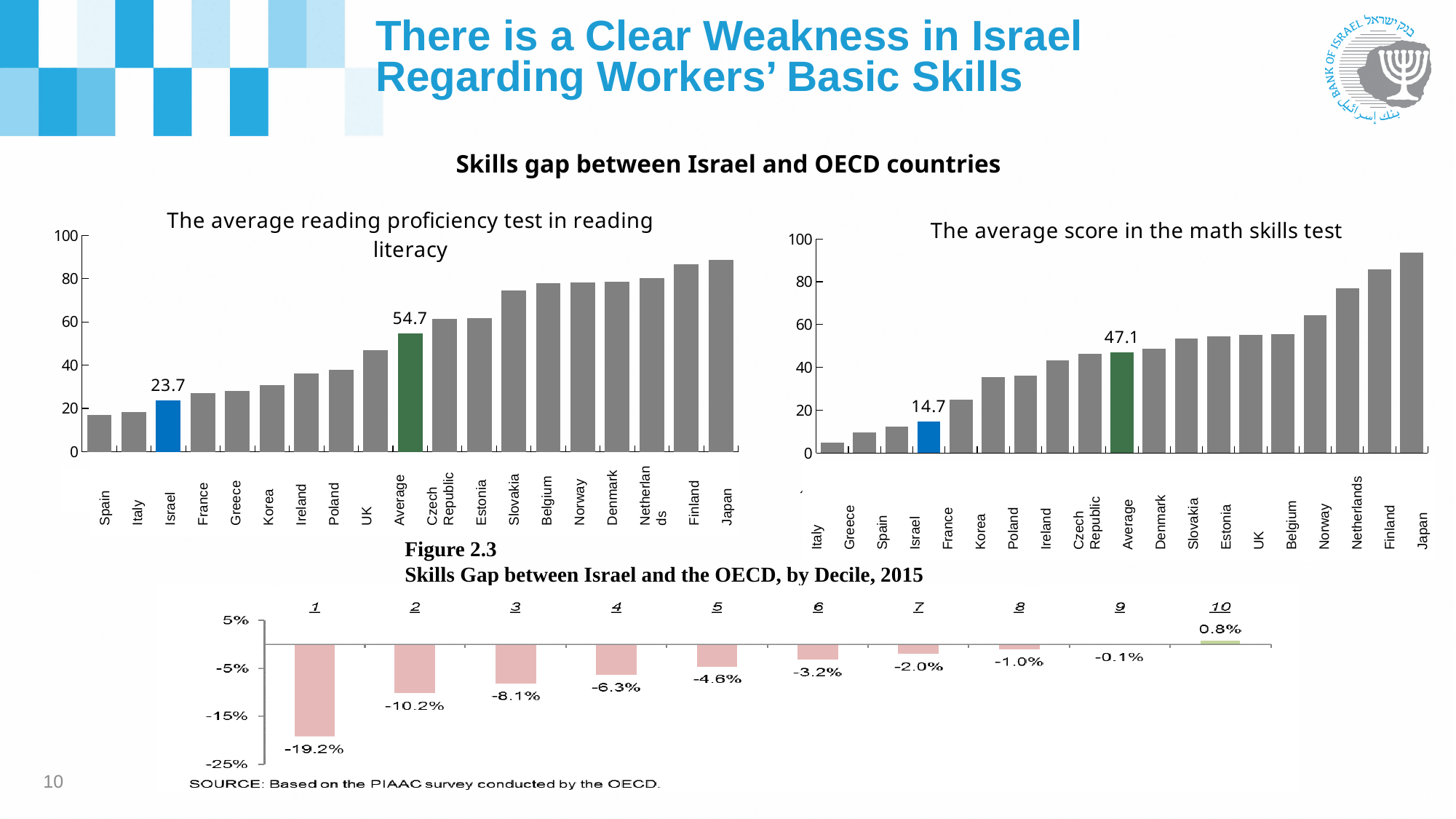
In the reading literacy chart, what is the value for Average? 54.7 In the math skills test chart, what is the difference between the Average value and Israel's value? 32.4 In the math skills test chart, which country has the lowest value? Italy In the reading literacy chart, what is the difference between the Average value and Israel's value? 31.0 In the reading literacy chart, which country has the highest value? Japan In the Skills Gap by Decile chart, how many deciles are plotted? 10 In the reading literacy chart, what is the value for Israel? 23.7 In the math skills test chart, what is the value for Israel? 14.7 In the Skills Gap by Decile chart, do the values rise or fall from decile 1 to decile 10? rise In the math skills test chart, what is the value for Average? 47.1 In the Skills Gap by Decile chart, what is the value for decile 1? -19.2% In the Skills Gap by Decile chart, what is the value for decile 10? 0.8%